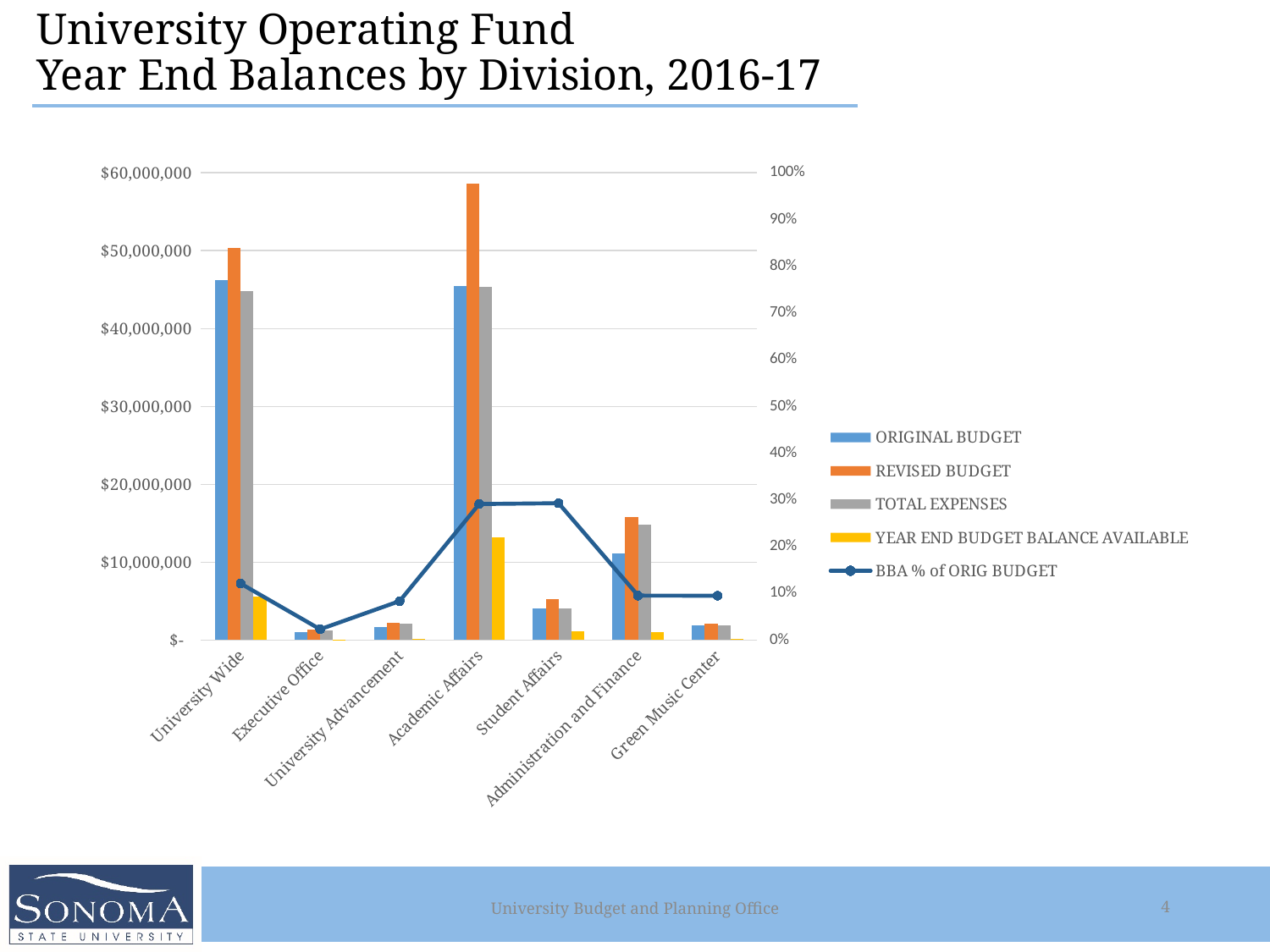
Is the Year End Budget Balance Available for Academic Affairs greater or less than $10,000,000? greater Is the BBA % of ORIG BUDGET for University Wide greater or less than 20%? less Which division has the highest Revised Budget? Academic Affairs Which division has the highest Year End Budget Balance Available? Academic Affairs How many series does the legend list? 5 How many divisions are shown along the x axis? 7 Which series is plotted as a line rather than bars? BBA % of ORIG BUDGET Is the Revised Budget for Academic Affairs greater or less than $50,000,000? greater Which division has the lowest Original Budget? Executive Office What kind of chart is shown on the slide? bar chart with a line Which has the larger Revised Budget, University Wide or Academic Affairs? Academic Affairs